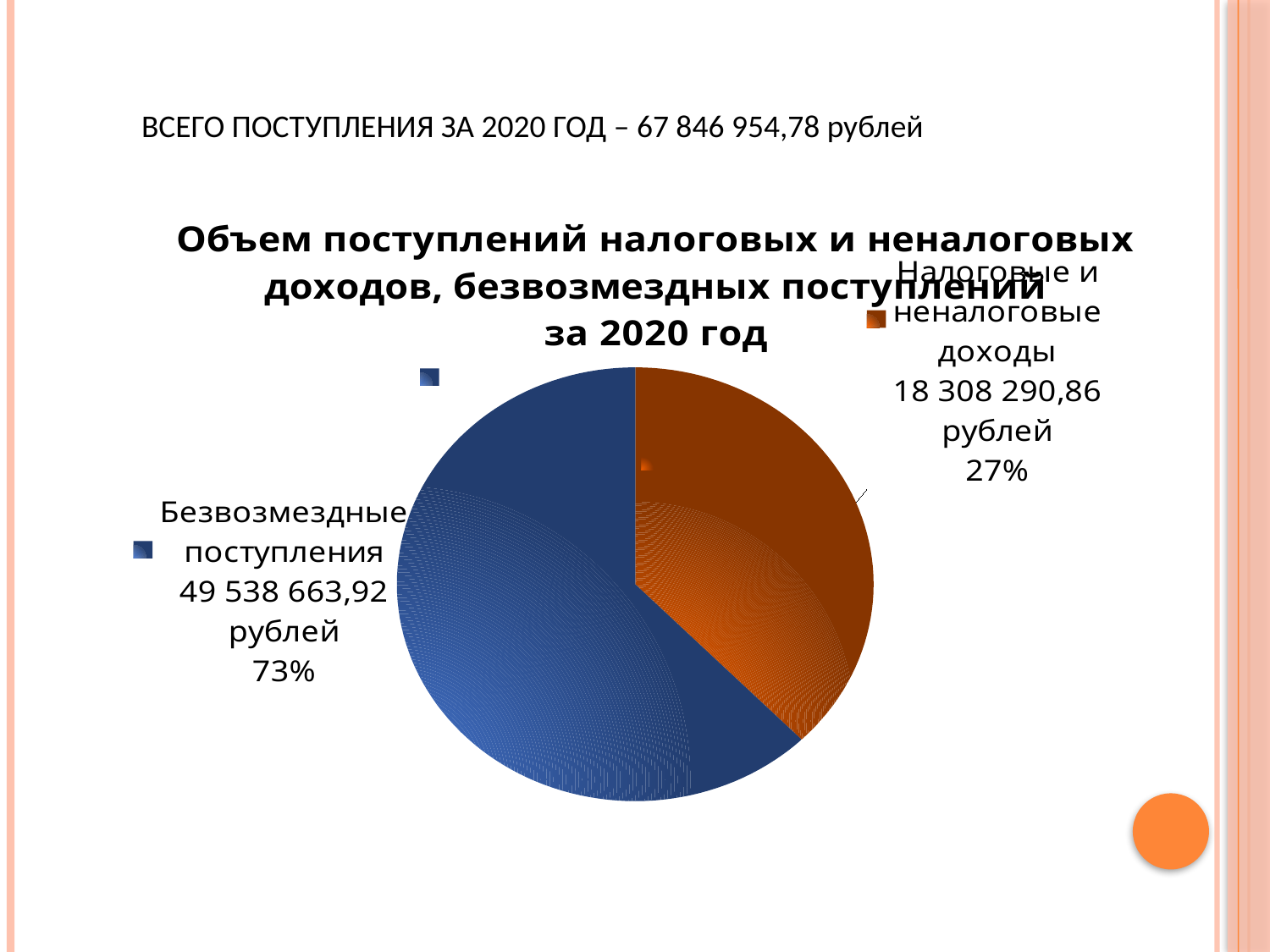
What share of the pie does "Налоговые и неналоговые доходы" represent? 27% What share of the pie does "Безвозмездные поступления" represent? 73% Which category has the smallest slice of the pie? Налоговые и неналоговые доходы What is the difference in percentage points between the shares of "Безвозмездные поступления" and "Налоговые и неналоговые доходы"? 46 percentage points What is the value shown for "Безвозмездные поступления"? 49 538 663,92 рублей Which is larger: "Безвозмездные поступления" or "Налоговые и неналоговые доходы"? Безвозмездные поступления What kind of chart is shown on the slide? Pie chart What is the value shown for "Налоговые и неналоговые доходы"? 18 308 290,86 рублей Which category has the largest slice of the pie? Безвозмездные поступления How many slices does the pie chart have? 2 What colour is the slice for "Налоговые и неналоговые доходы"? Orange What is the title of the pie chart? Объем поступлений налоговых и неналоговых доходов, безвозмездных поступлений за 2020 год